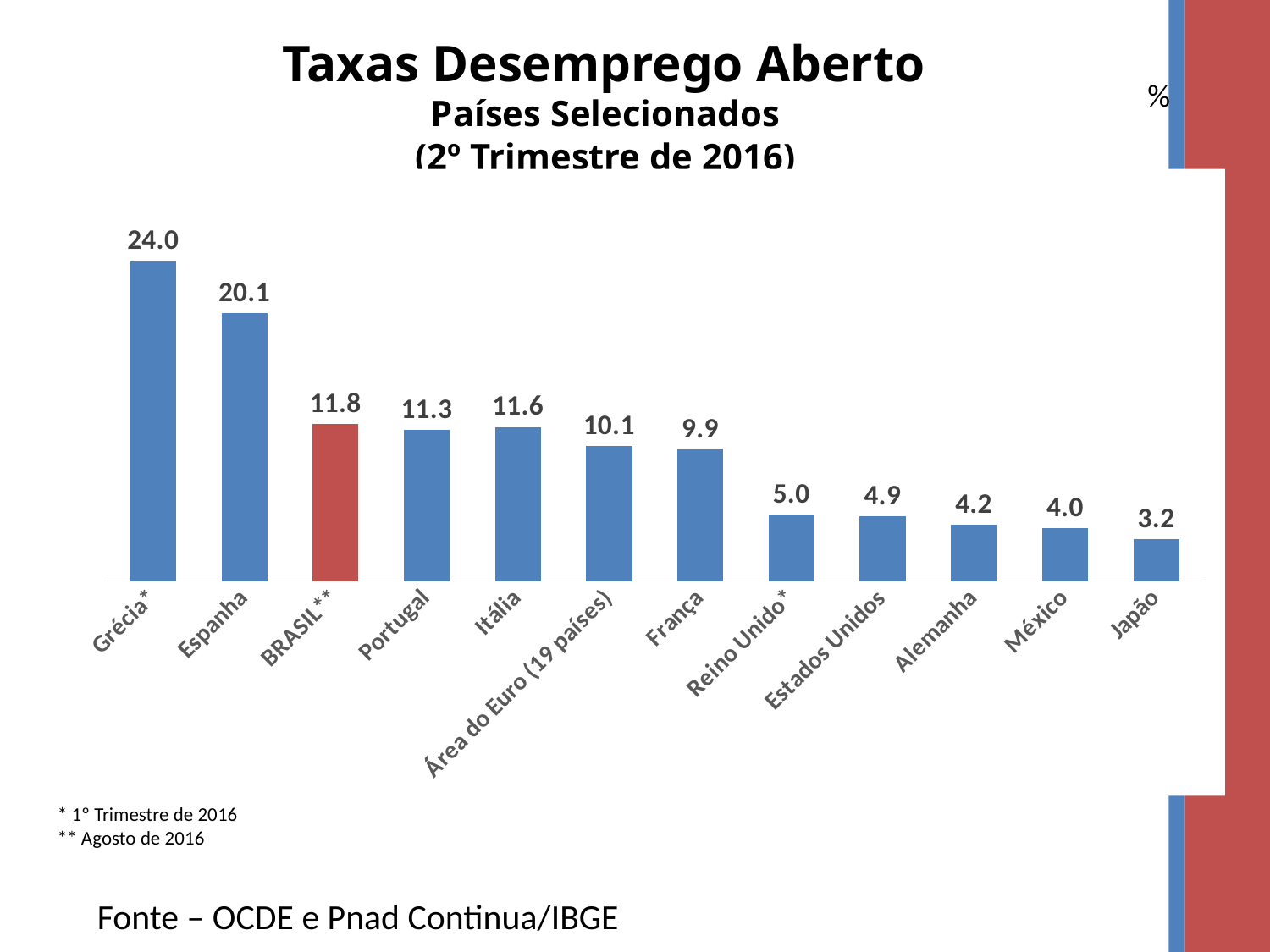
What is the difference between the values for Grécia* and Espanha? 3.9 Which country has the highest unemployment rate on the chart? Grécia* What value is shown for BRASIL**? 11.8 Which has a higher value, Espanha or França? Espanha What is the difference between the values for BRASIL** and Alemanha? 7.6 Which country has the lowest unemployment rate on the chart? Japão What is the unemployment rate shown for Grécia*? 24.0 What type of chart is shown on the slide? Bar chart Which bar is shown in a different colour (red) from the others? BRASIL** Which has a higher value, Portugal or Itália? Itália How many countries or regions are shown on the chart? 12 What value is shown for Área do Euro (19 países)? 10.1